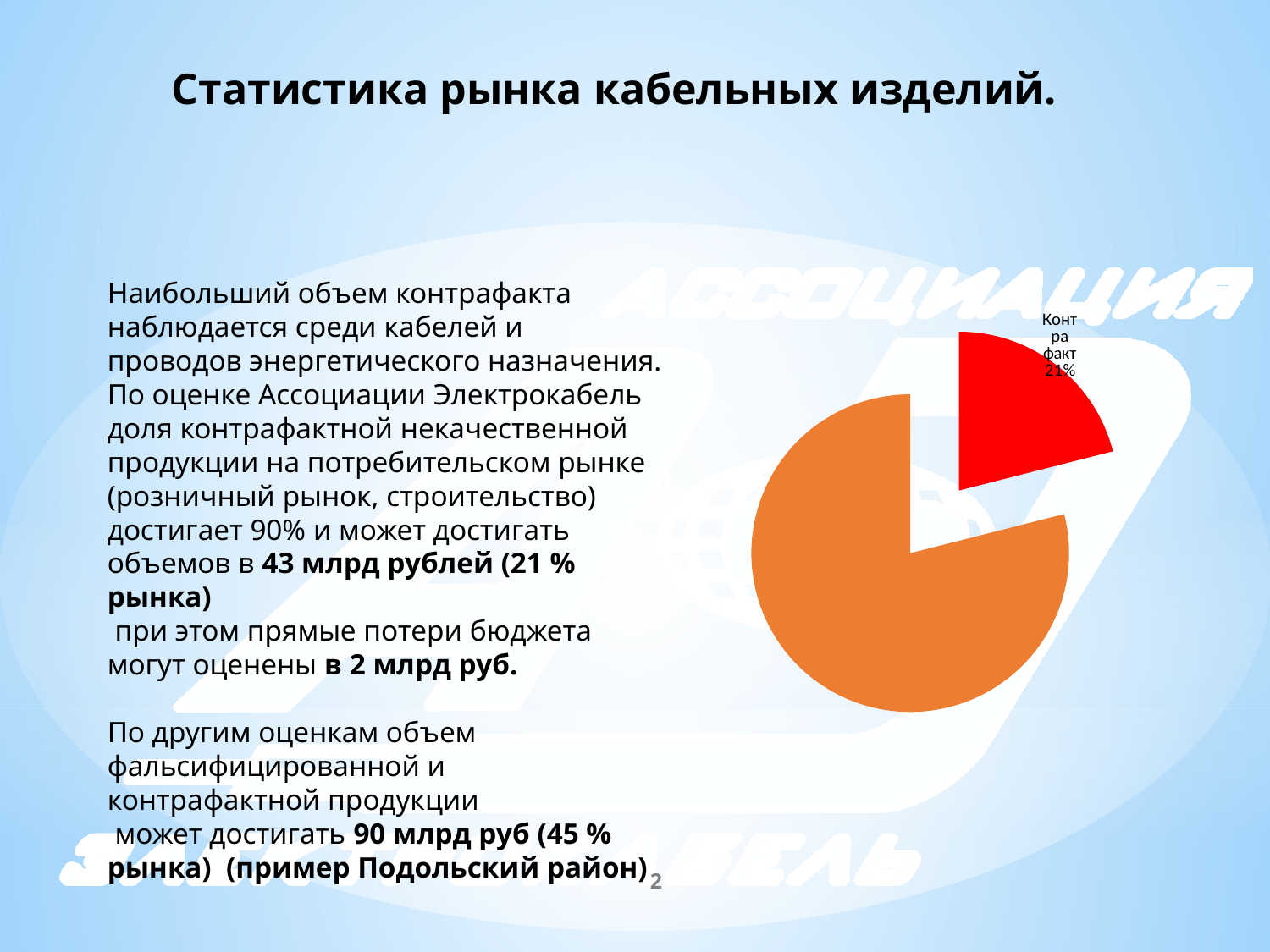
What colour is the "Контрафакт" slice in the pie chart? red Is the "Контрафакт" slice pulled out (exploded) from the rest of the pie? yes Which slice of the pie chart is the smallest? Контрафакт What kind of chart is shown on the slide? pie chart How many slices does the pie chart have? 2 What share of the pie does the "Контрафакт" slice represent? 21% Which slice of the pie chart is larger, the red one or the orange one? the orange one